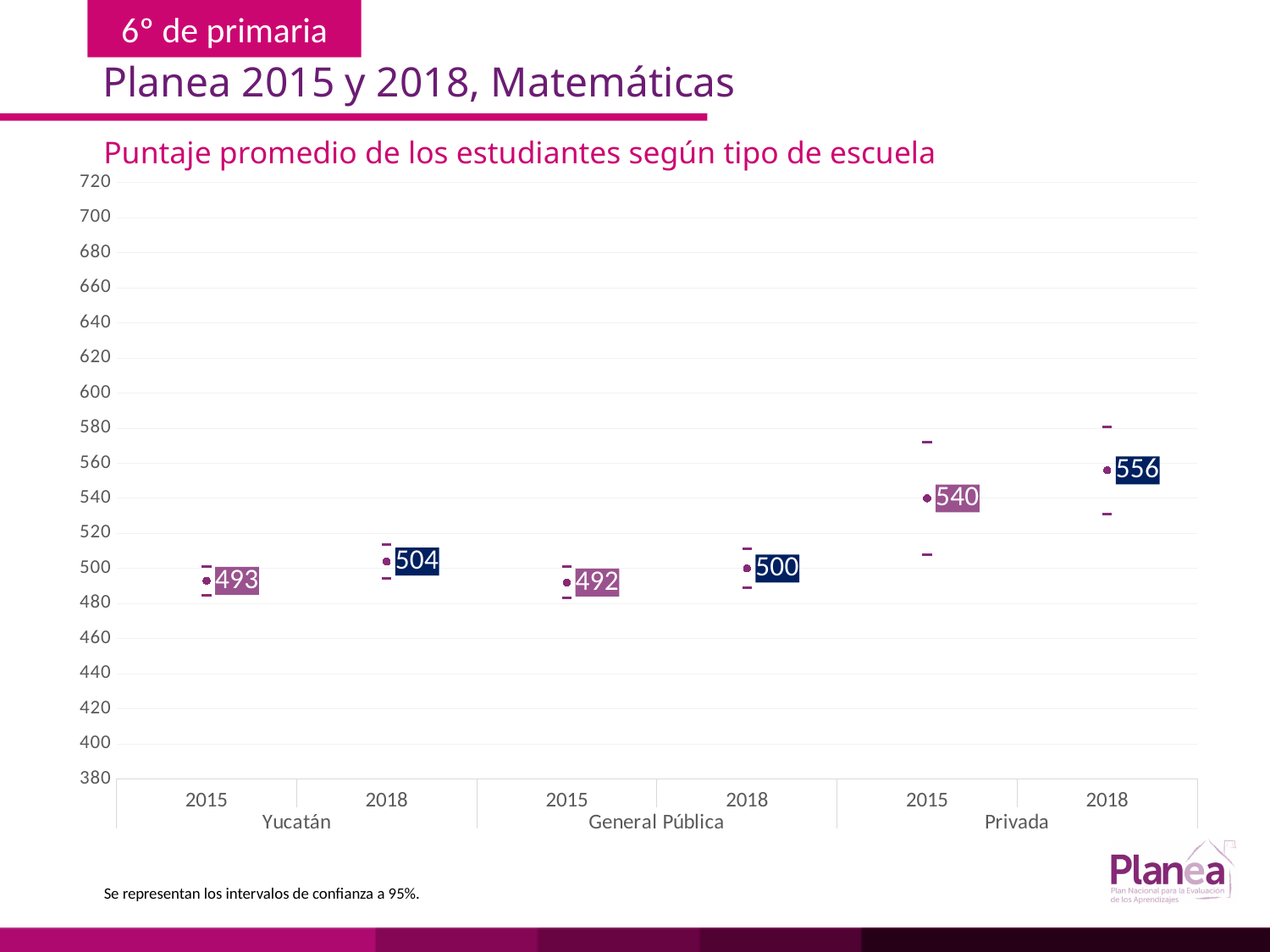
By how many points did the Privada average score increase from 2015 to 2018? 16 What is the title of the chart? Puntaje promedio de los estudiantes según tipo de escuela What is the average score for Yucatán in 2018? 504 Which is larger, the Yucatán 2015 score or the General Pública 2015 score? Yucatán 2015 How many data points are plotted in the chart? 6 What is the difference between the Yucatán 2018 score and the General Pública 2018 score? 4 What is the average score for General Pública in 2015? 492 Which school type and year has the highest average score? Privada 2018 What is the average score for Privada in 2018? 556 Which school type and year has the lowest average score? General Pública 2015 What is the average score for Yucatán in 2015? 493 Did the average score for each school type rise or fall from 2015 to 2018? Rise